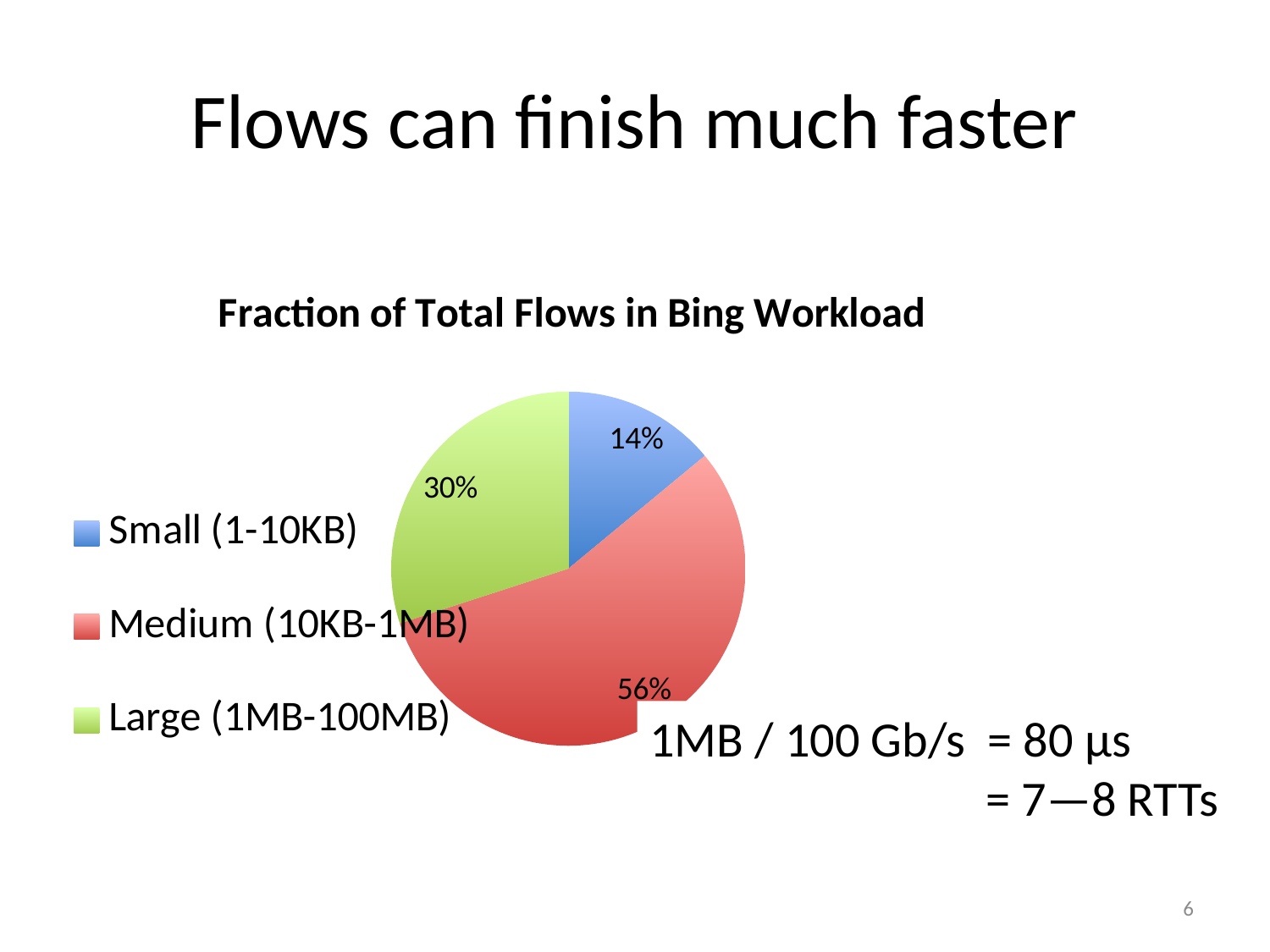
What is the difference in percentage points between the Large (1MB-100MB) and Small (1-10KB) shares? 16 What share of total flows is Large (1MB-100MB)? 30% What share of total flows is Small (1-10KB)? 14% What share of total flows is Medium (10KB-1MB)? 56% What kind of chart is shown on the slide? Pie chart Which is larger, the share for Large (1MB-100MB) or the share for Small (1-10KB)? Large (1MB-100MB) Which category has the largest share of total flows? Medium (10KB-1MB) What is the title of the chart? Fraction of Total Flows in Bing Workload Which category has the smallest share of total flows? Small (1-10KB) What is the difference in percentage points between the Medium (10KB-1MB) and Large (1MB-100MB) shares? 26 How many categories does the pie chart show? 3 What colour is the slice for Medium (10KB-1MB)? Red